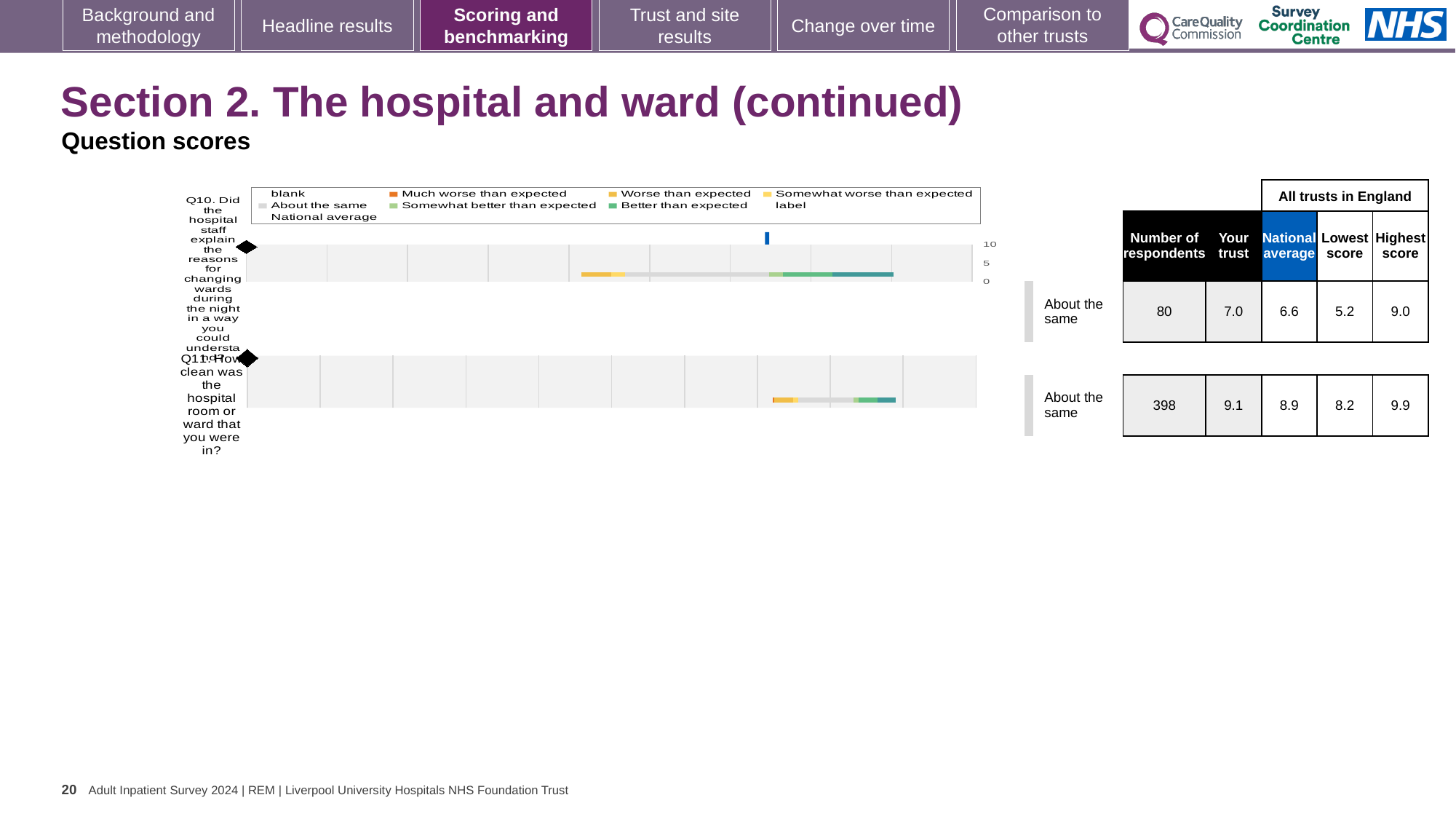
What is the lowest score among all trusts in England for Q10? 5.2 What is the 'Your trust' score for Q11 (how clean was the hospital room or ward)? 9.1 What kind of chart is used to show the question scores on this slide? Bar chart What is the national average score for Q10? 6.6 What is the national average score for Q11? 8.9 Which question has the higher 'Your trust' score, Q10 or Q11? Q11 What is the 'Your trust' score for Q10 (explaining reasons for changing wards during the night)? 7.0 How many respondents answered Q10? 80 How many respondents answered Q11? 398 How many questions (Q10 and Q11) are plotted on this slide? 2 By how much does the trust's score for Q11 exceed the national average for Q11? 0.2 What is the highest score among all trusts in England for Q11? 9.9